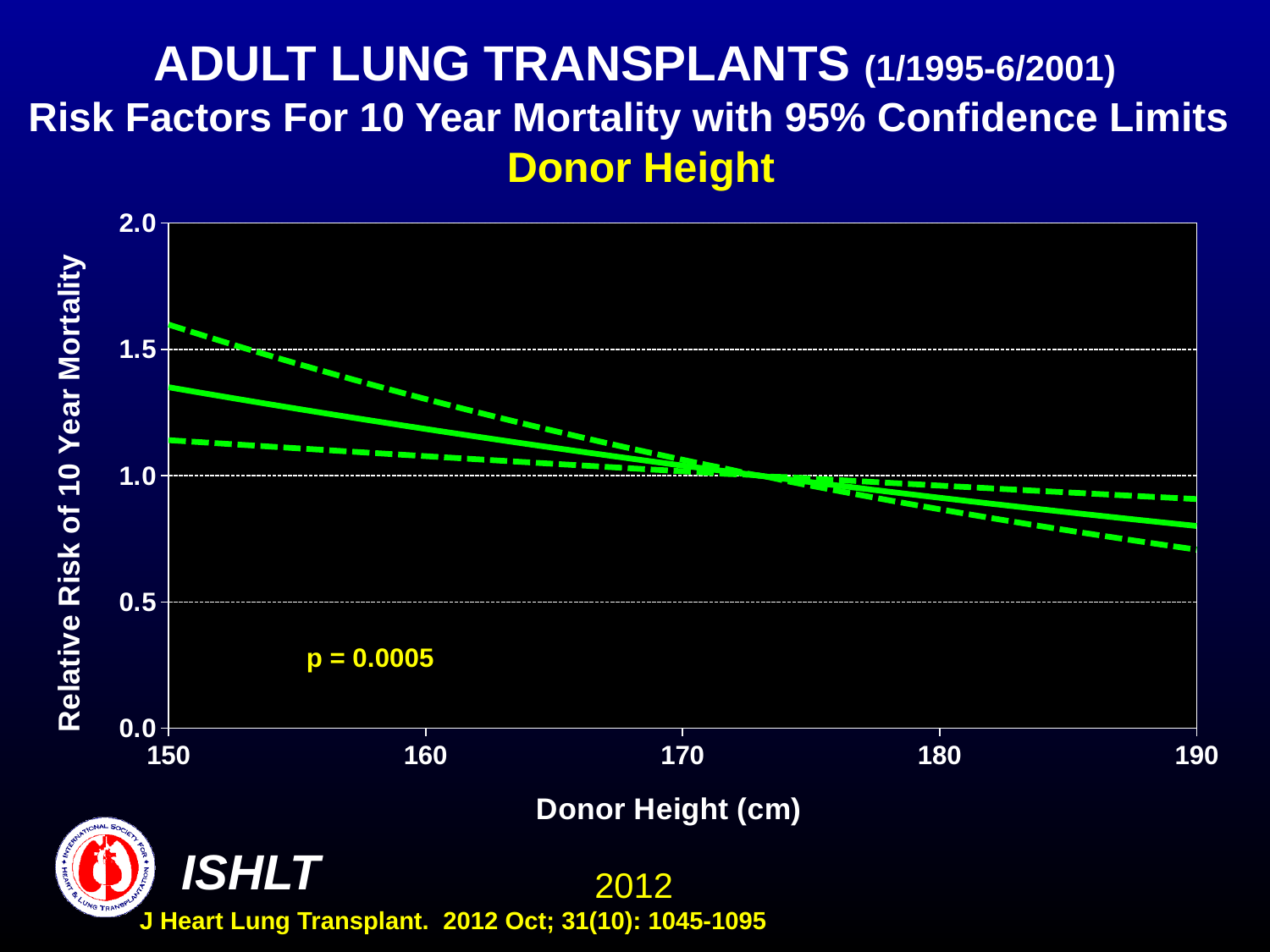
Is the relative risk (solid line) at a donor height of 150 cm greater or less than 1.0? greater Does the relative risk of 10 year mortality rise or fall as donor height increases from 150 cm to 190 cm? fall What kind of chart is shown on the slide? line chart Is the relative risk (solid line) at a donor height of 160 cm greater or less than 1.0? greater Is the lower 95% confidence limit at a donor height of 190 cm greater or less than 1.0? less What is the p-value shown on the chart? p = 0.0005 What is the label of the x axis? Donor Height (cm) How many lines are plotted on the chart? 3